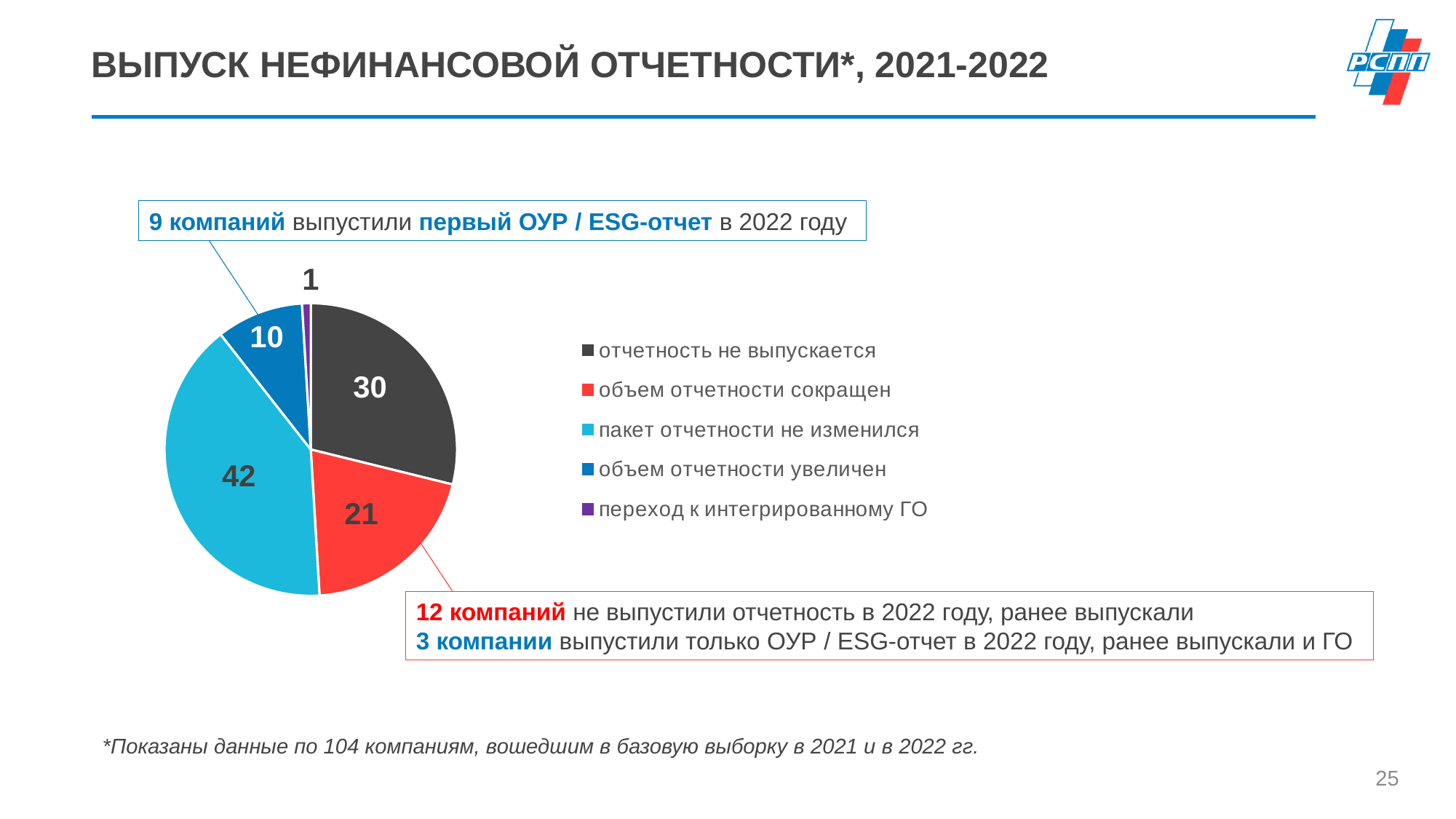
Which is larger: the value for 'объем отчетности сокращен' or the value for 'объем отчетности увеличен'? объем отчетности сокращен What is the value for the slice 'пакет отчетности не изменился'? 42 What is the value for the slice 'переход к интегрированному ГО'? 1 What kind of chart is shown on the slide? Pie chart What is the value for the slice 'объем отчетности увеличен'? 10 What is the difference between the values for 'пакет отчетности не изменился' and 'отчетность не выпускается'? 12 What is the value for the slice 'отчетность не выпускается'? 30 What is the value for the slice 'объем отчетности сокращен'? 21 Which category has the largest slice of the pie? пакет отчетности не изменился Which category has the smallest slice of the pie? переход к интегрированному ГО What colour is the slice for 'объем отчетности сокращен'? Red How many categories does the pie chart have? 5